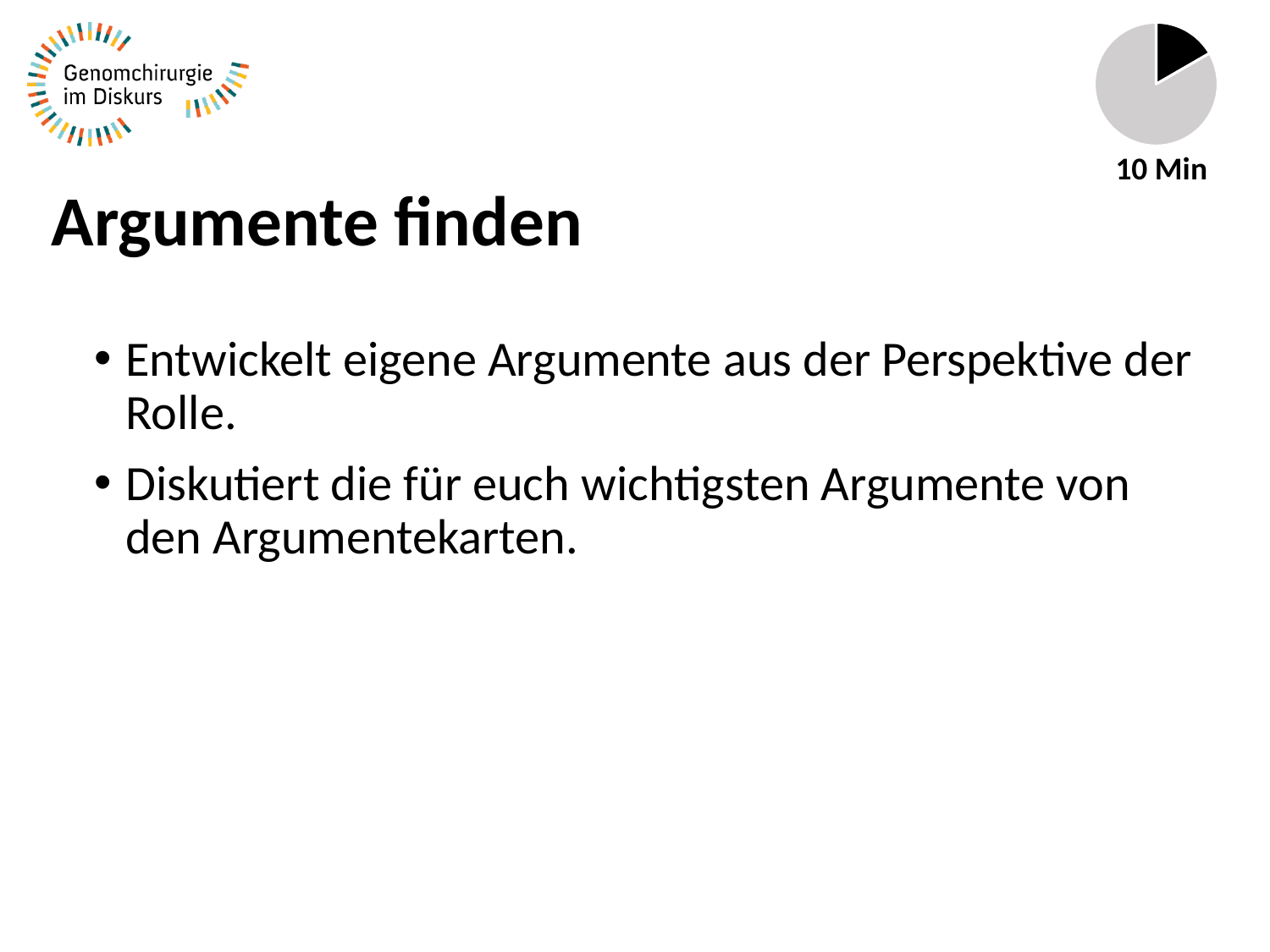
What colour is the smaller slice of the pie chart in the top right corner? black In the pie chart in the top right corner, which slice is larger, the black one or the grey one? grey What label is printed directly below the pie chart in the top right corner? 10 Min How many slices does the pie chart in the top right corner have? 2 What kind of chart is shown in the top right corner of the slide? pie chart